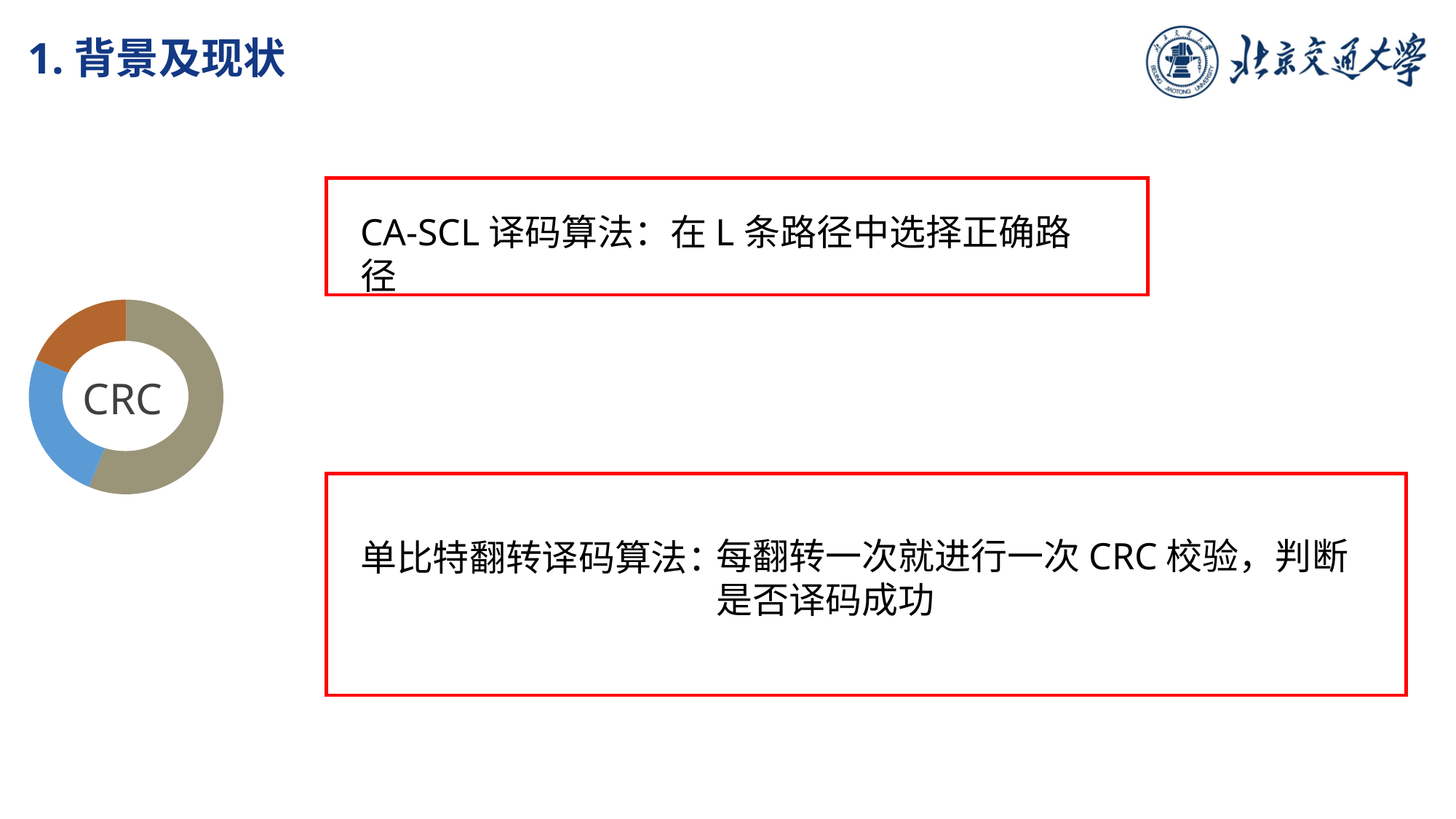
Does the doughnut chart have a legend? No Is the orange slice of the doughnut chart larger or smaller than the grey slice? smaller What text is written in the centre of the doughnut chart? CRC Which colour slice of the doughnut chart is the largest? grey How many slices does the doughnut chart have? 3 Is the grey slice of the doughnut chart larger or smaller than the blue slice? larger What kind of chart is shown on the left of the slide? doughnut chart